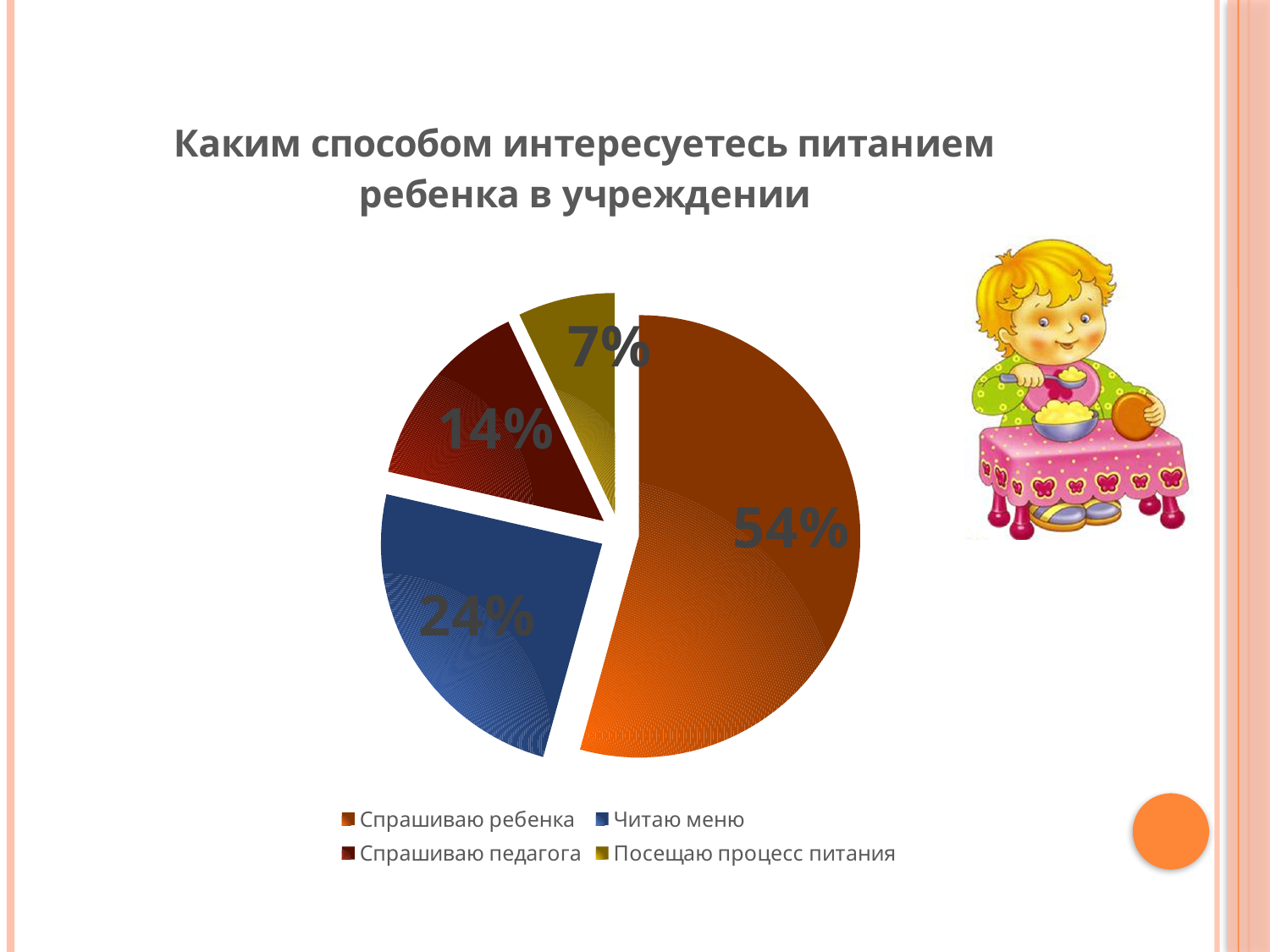
What is the title of the chart? Каким способом интересуетесь питанием ребенка в учреждении How many categories does the pie chart have? 4 What share of the pie does "Посещаю процесс питания" have? 7% Which category has the largest slice of the pie? Спрашиваю ребенка What type of chart is shown on the slide? pie chart What share of the pie does "Спрашиваю ребенка" have? 54% Which category has the smallest slice of the pie? Посещаю процесс питания What share of the pie does "Спрашиваю педагога" have? 14% What is the difference between the shares for "Спрашиваю педагога" and "Посещаю процесс питания"? 7% Which is larger: the share for "Читаю меню" or the share for "Спрашиваю педагога"? Читаю меню What is the difference between the shares for "Спрашиваю ребенка" and "Читаю меню"? 30%